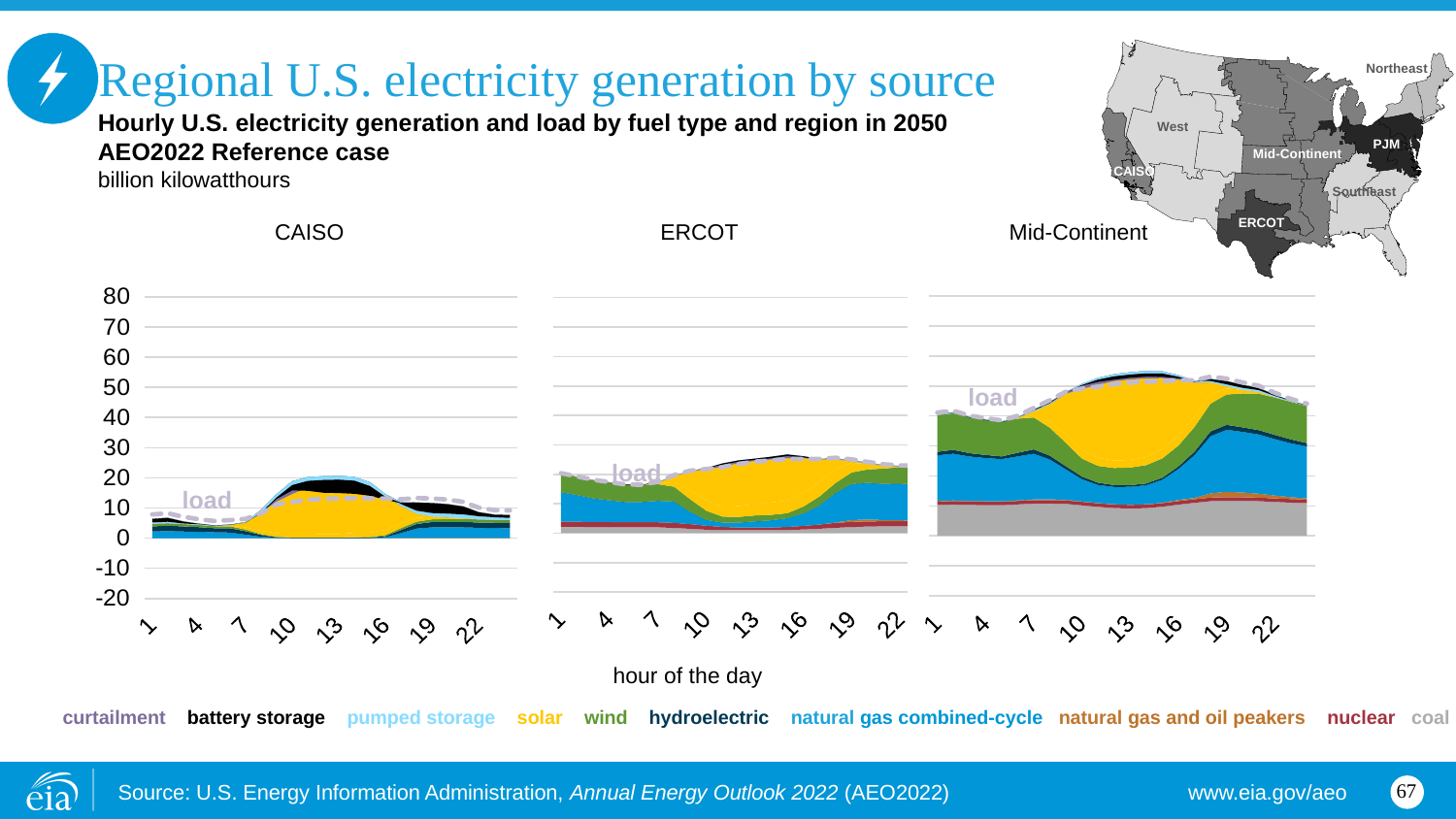
In the ERCOT chart, is the peak total generation around hour 16 greater or less than 50? less Which region's chart shows the highest peak hourly generation? Mid-Continent In the CAISO chart, is the peak total generation around hour 13 greater or less than 40? less Which region's chart shows the lowest peak hourly generation? CAISO In the CAISO chart, does total generation rise or fall between hour 7 and hour 13? rise Is the peak generation in the ERCOT chart larger or smaller than the peak generation in the CAISO chart? larger What unit is given for the values on the charts? billion kilowatthours What is the label of the shared x axis beneath the three charts? hour of the day How many regional charts are shown on the slide? 3 What kind of chart is used for the CAISO, ERCOT and Mid-Continent panels? stacked area chart In the Mid-Continent chart, is the peak total generation around hour 13 greater or less than 40? greater How many fuel-type series does the legend list below the charts? 10